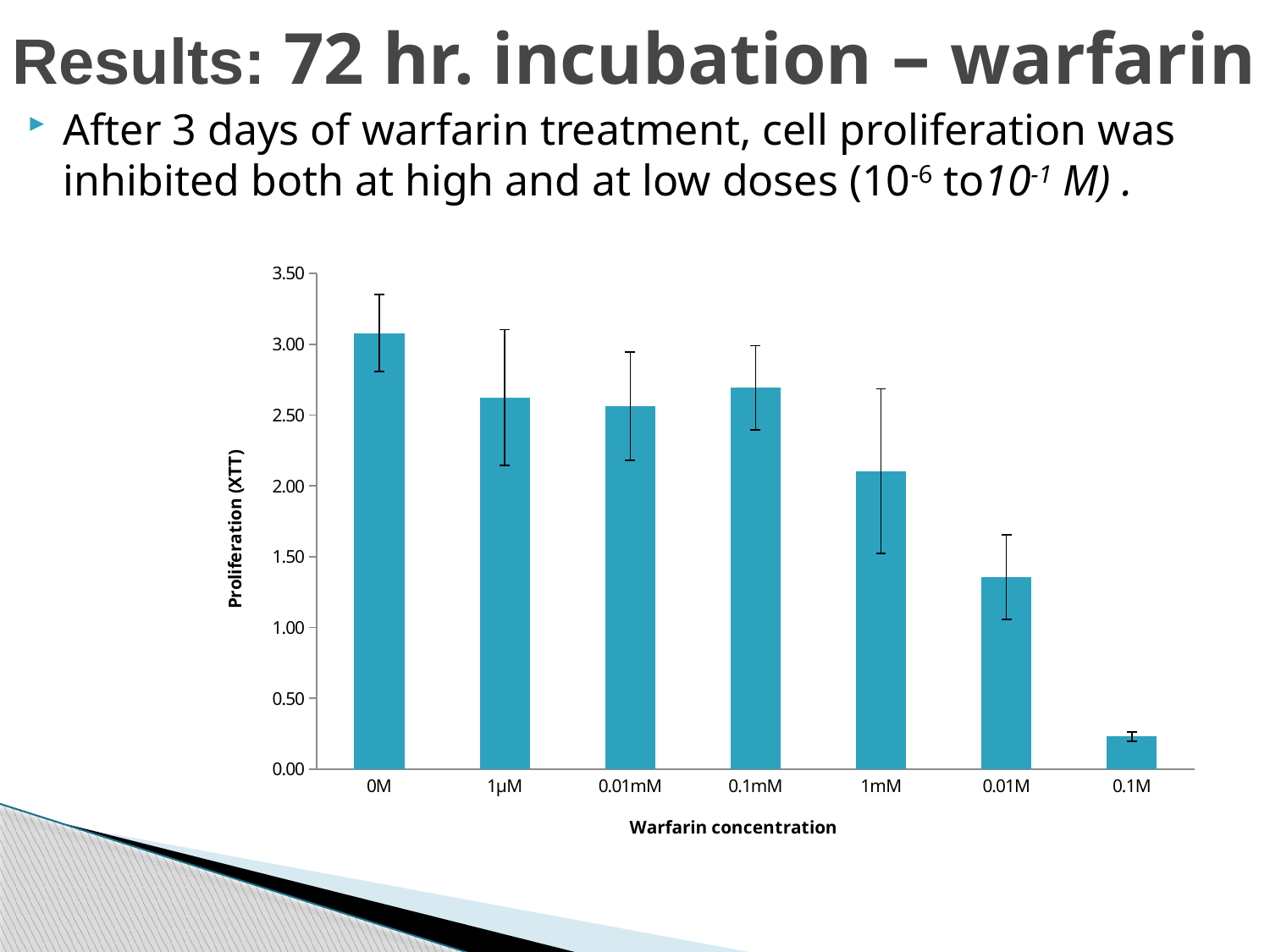
Which has a larger proliferation value, 0.1mM or 1mM? 0.1mM Do the proliferation values generally rise or fall as warfarin concentration increases along the x axis? fall Is the proliferation value for 0M greater or less than 3.00? greater Which has a larger proliferation value, 0.01M or 0.1M? 0.01M Is the proliferation value for 0.1M greater or less than 0.50? less Is the proliferation value for 0.01M greater or less than 1.50? less Which warfarin concentration has the lowest proliferation (XTT) value? 0.1M What kind of chart is shown on the slide? bar chart How many warfarin concentrations are plotted on the x axis? 7 Which warfarin concentration has the highest proliferation (XTT) value? 0M What is the label of the y axis? Proliferation (XTT)